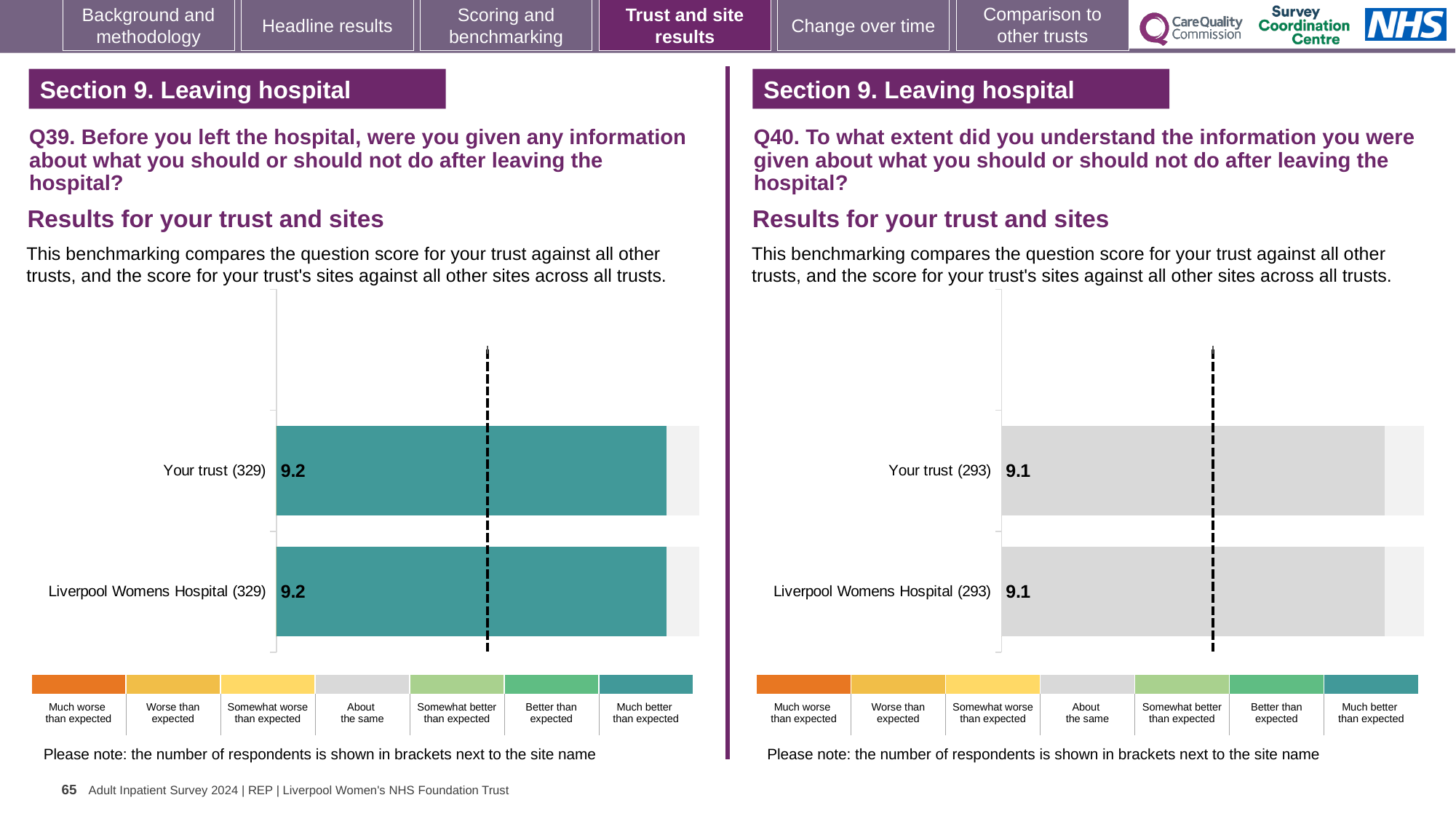
How many bars are plotted in the Q39 chart? 2 In the Q39 chart, what is the difference between the score for Your trust and the score for Liverpool Womens Hospital? 0 In the Q40 chart, what is the difference between the score for Your trust and the score for Liverpool Womens Hospital? 0 How many bars are plotted in the Q40 chart? 2 In the Q40 chart, what is the score for Your trust (293)? 9.1 In the Q39 chart, what is the score for Liverpool Womens Hospital (329)? 9.2 In the Q39 chart, which benchmark category does the colour of the bars correspond to? Much better than expected In the Q40 chart, what is the score for Liverpool Womens Hospital (293)? 9.1 What kind of chart is the Q39 chart? Bar chart In the Q39 chart, what is the score for Your trust (329)? 9.2 In the Q39 chart, how many respondents are shown in brackets for Your trust? 329 In the Q40 chart, which benchmark category does the colour of the bars correspond to? About the same